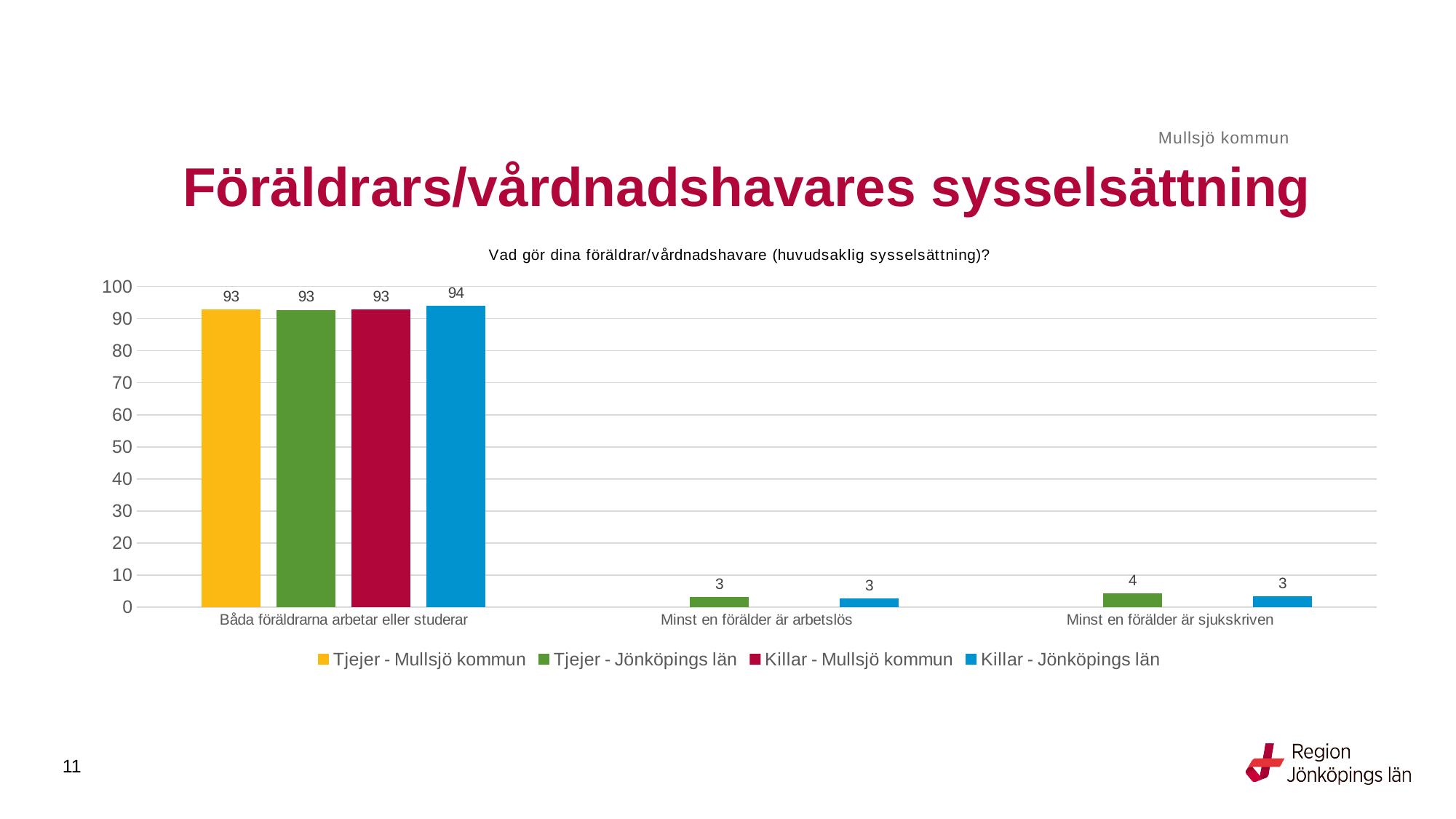
What is the value for Tjejer - Jönköpings län in the category 'Minst en förälder är sjukskriven'? 4 What is the title of the chart? Vad gör dina föräldrar/vårdnadshavare (huvudsaklig sysselsättning)? What is the value for Tjejer - Mullsjö kommun in the category 'Båda föräldrarna arbetar eller studerar'? 93 What is the value for Killar - Jönköpings län in the category 'Båda föräldrarna arbetar eller studerar'? 94 What is the value for Killar - Jönköpings län in the category 'Minst en förälder är arbetslös'? 3 What kind of chart is shown on the slide? bar chart What is the difference between the Killar - Jönköpings län value and the Killar - Mullsjö kommun value in the category 'Båda föräldrarna arbetar eller studerar'? 1 Is the value for Tjejer - Jönköpings län in 'Båda föräldrarna arbetar eller studerar' greater or less than 90? greater In the category 'Minst en förälder är sjukskriven', which is larger: Tjejer - Jönköpings län or Killar - Jönköpings län? Tjejer - Jönköpings län How many series does the legend list? 4 Which series has the highest value in the category 'Båda föräldrarna arbetar eller studerar'? Killar - Jönköpings län How many categories are shown on the x axis? 3